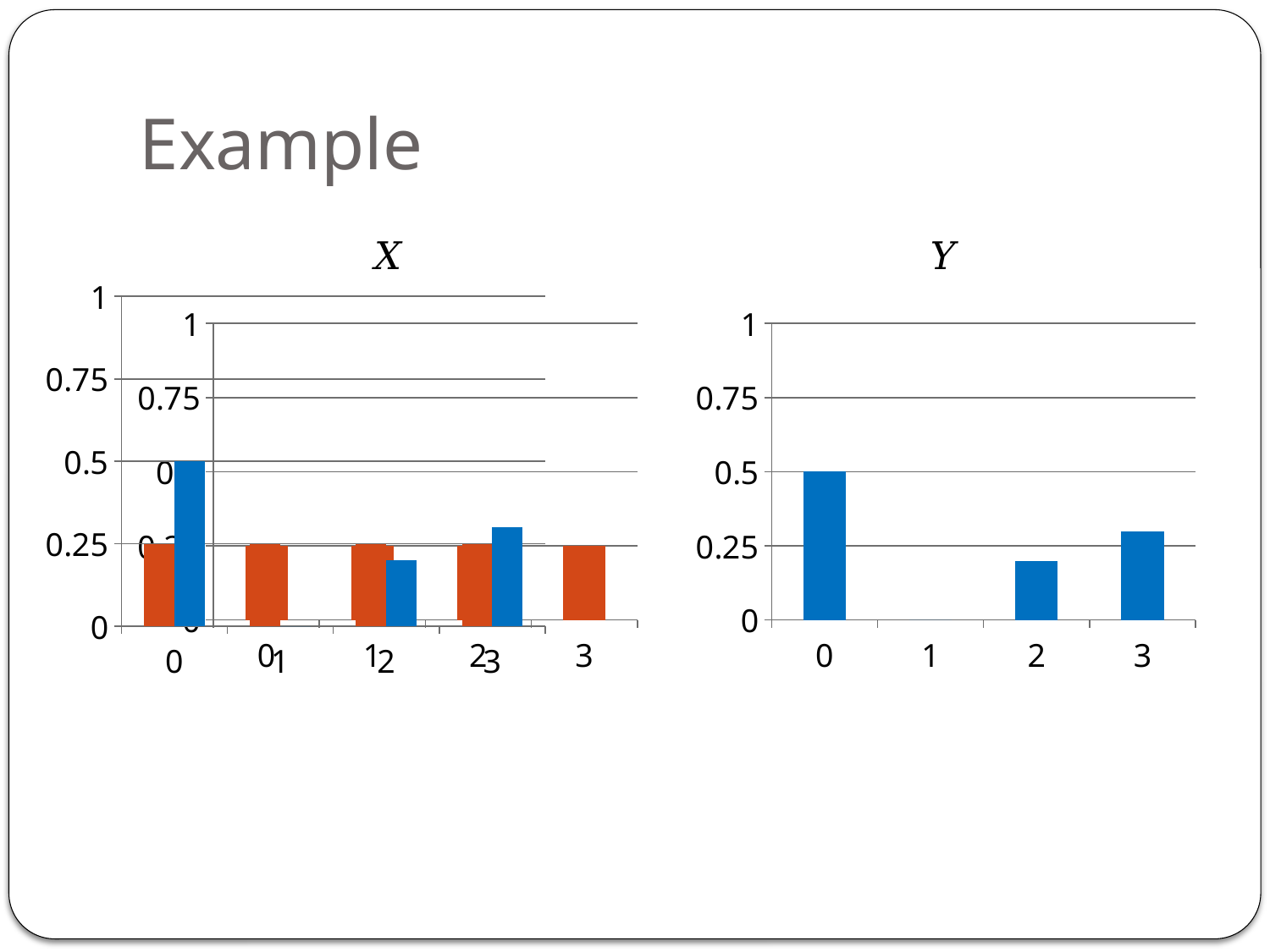
What colour are the bars in the chart titled Y? blue What kind of chart is the chart titled Y? bar chart In the chart titled X, what value does the orange bar for category 3 reach? 0.25 In the chart titled Y, which category has the lowest value? 1 In the chart titled Y, is the value for category 3 greater or less than 0.25? greater In the chart titled Y, which category has the highest bar? 0 In the chart titled Y, is the value for category 0 greater or less than 0.25? greater What is the title of the chart on the right of the slide? Y In the chart titled Y, which is larger, the value for category 0 or the value for category 3? 0 In the chart titled Y, is the value for category 2 greater or less than 0.25? less In the chart titled Y, what is the value for category 0? 0.5 In the chart titled Y, how many categories are shown on the x axis? 4